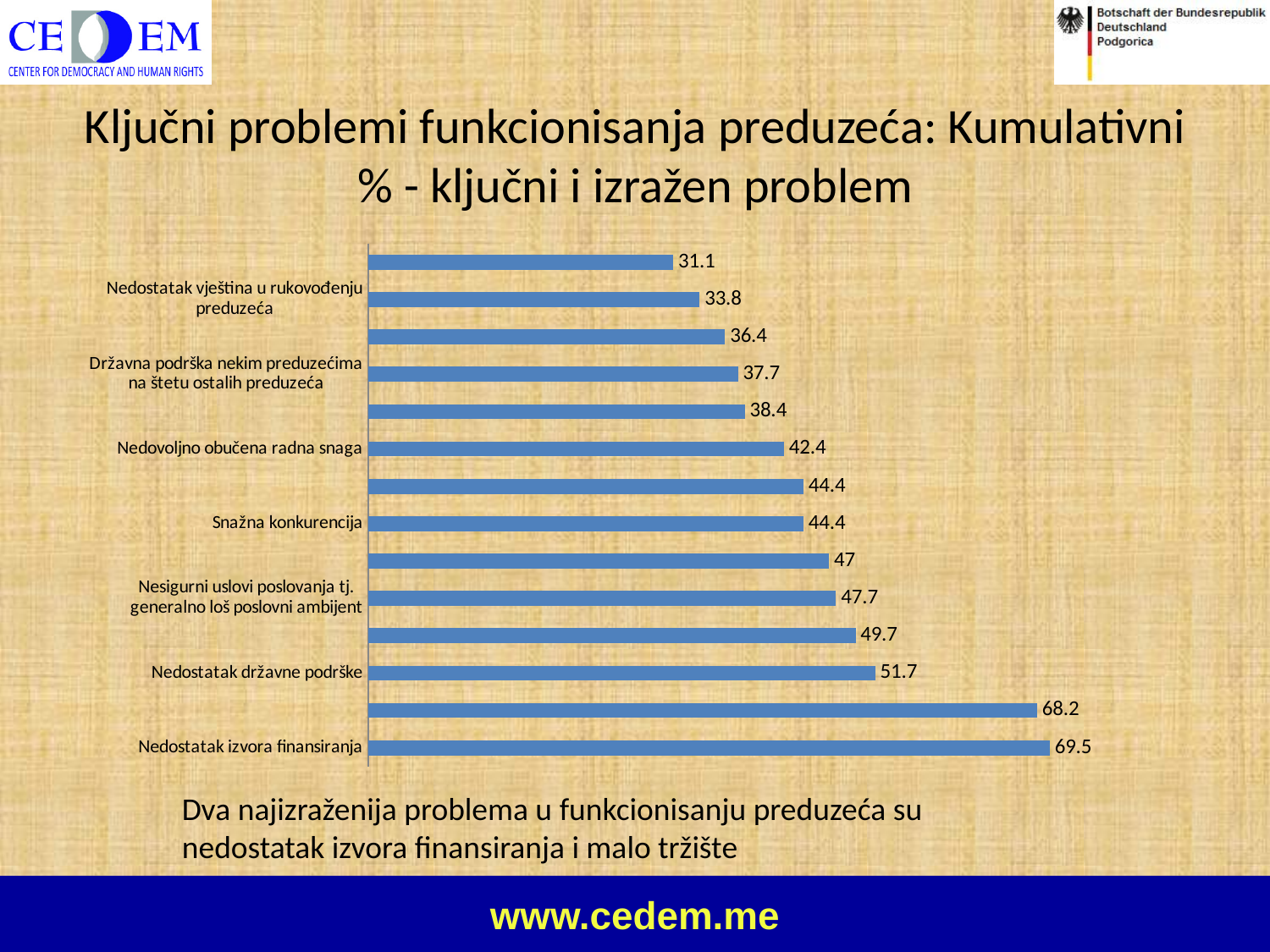
What is the difference between the values for 'Nedostatak izvora finansiranja' and 'Nedostatak državne podrške'? 17.8 What is the value for 'Nedostatak državne podrške'? 51.7 How many bars are plotted on the chart? 14 What is the value for 'Nedostatak izvora finansiranja'? 69.5 Which labeled category has the highest value? Nedostatak izvora finansiranja What is the smallest value shown on the chart? 31.1 What is the value for 'Nesigurni uslovi poslovanja tj. generalno loš poslovni ambijent'? 47.7 What is the value for 'Nedovoljno obučena radna snaga'? 42.4 Which is larger: the value for 'Nedovoljno obučena radna snaga' or for 'Državna podrška nekim preduzećima na štetu ostalih preduzeća'? Nedovoljno obučena radna snaga What kind of chart is shown on the slide? Bar chart What is the difference between the values for 'Nesigurni uslovi poslovanja tj. generalno loš poslovni ambijent' and 'Nedostatak vještina u rukovođenju preduzeća'? 13.9 What is the value for 'Snažna konkurencija'? 44.4